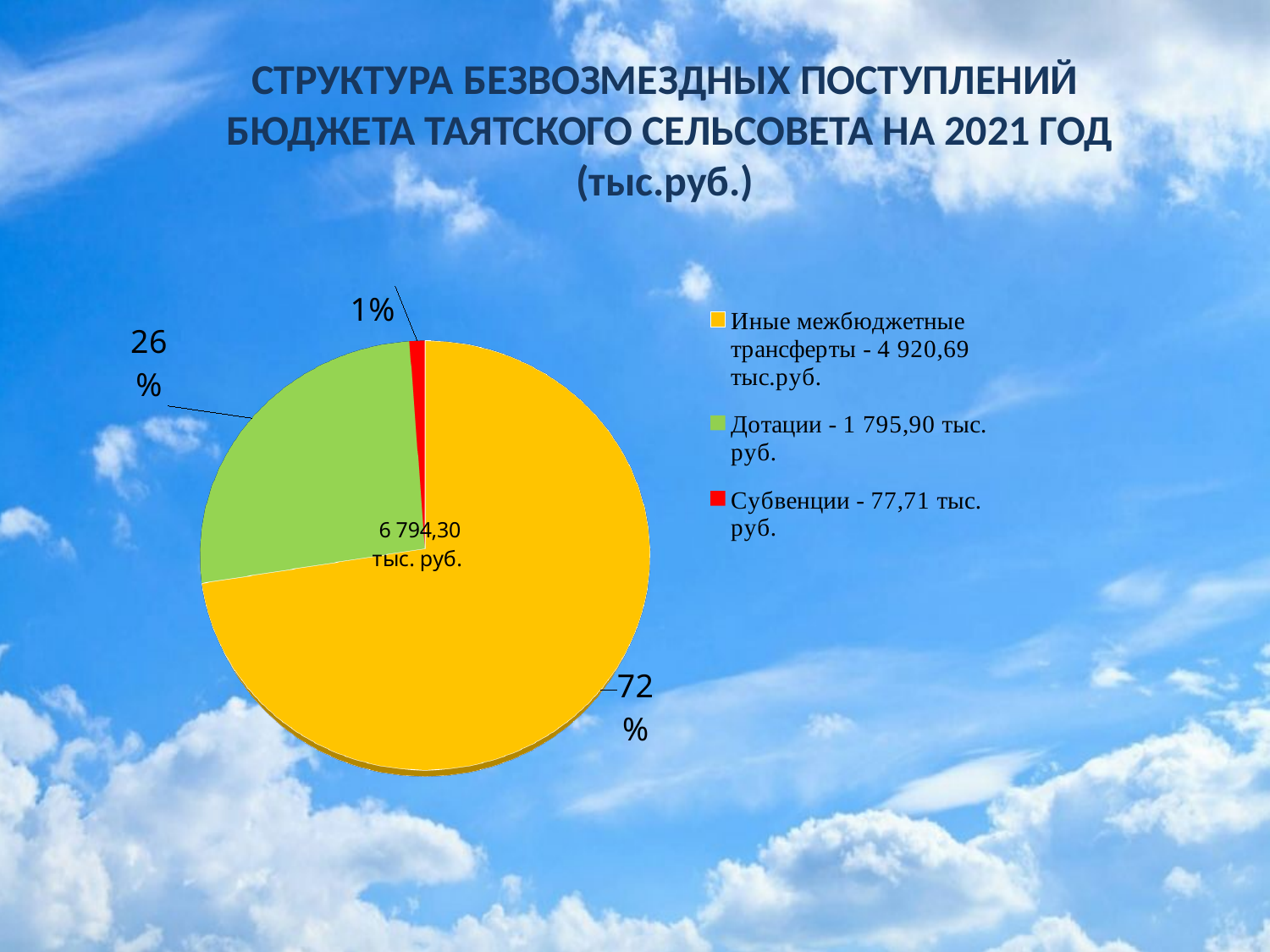
What share of the pie does the slice for Иные межбюджетные трансферты represent? 72% What colour is the slice for Иные межбюджетные трансферты? yellow According to the legend, what is the value for Субвенции? 77,71 тыс. руб. How many entries does the legend list? 3 Which is larger: the slice for Дотации or the slice for Субвенции? Дотации Which category has the largest slice of the pie? Иные межбюджетные трансферты According to the legend, what is the value for Дотации? 1 795,90 тыс. руб. What share of the pie does the slice for Субвенции represent? 1% What kind of chart is shown on the slide? pie chart How many slices does the pie chart have? 3 What share of the pie does the slice for Дотации represent? 26% Which category has the smallest slice of the pie? Субвенции